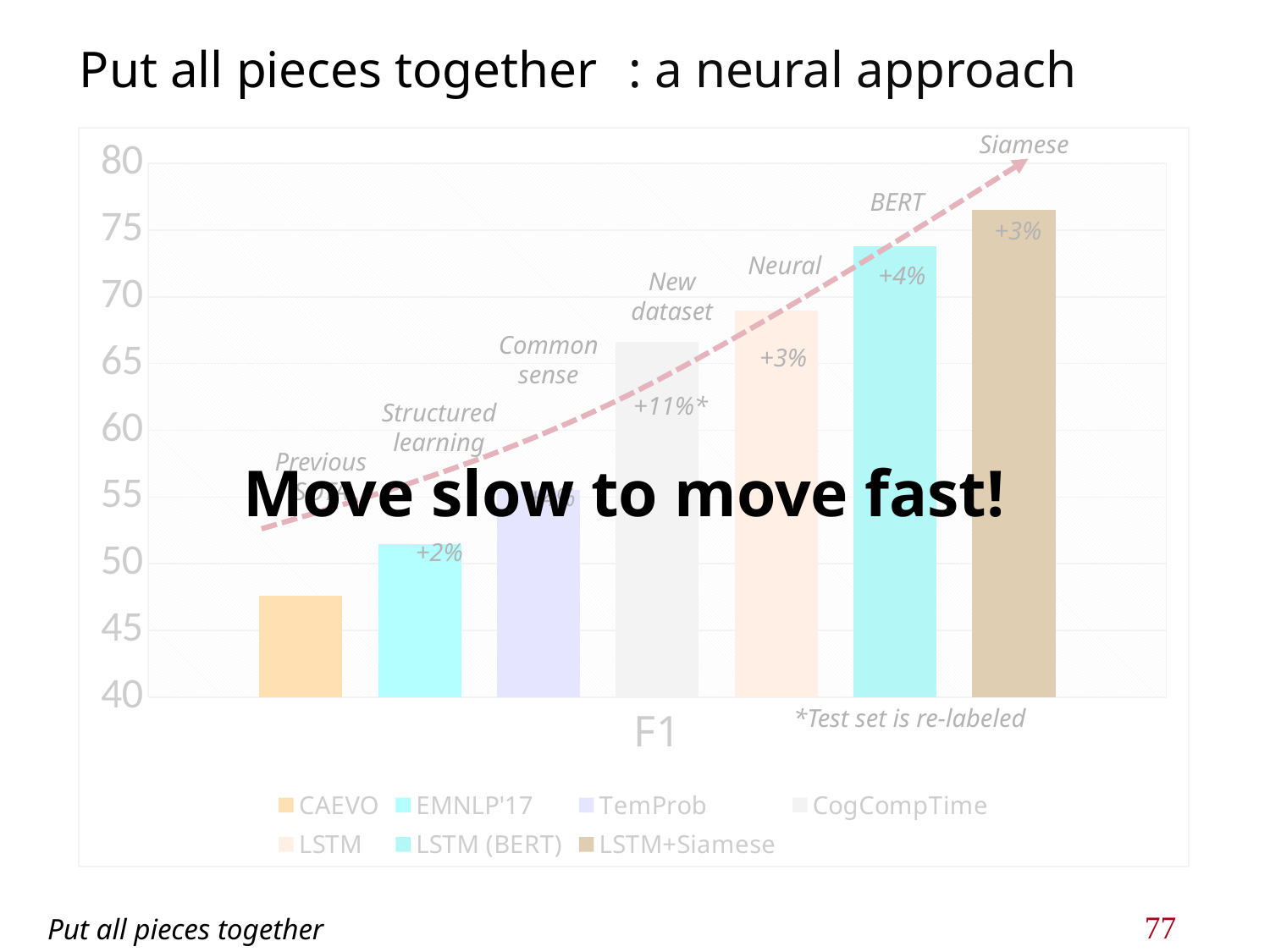
Is the F1 value for LSTM (BERT) greater or less than 70? greater Which series has the highest F1 bar? LSTM+Siamese Do the F1 bars rise or fall from left to right across the series? rise Is the F1 value for CAEVO greater or less than 50? less Which series has the lowest F1 bar? CAEVO Which is larger, the F1 bar for CogCompTime or the F1 bar for TemProb? CogCompTime How many categories are shown on the x axis? 1 Which is larger, the F1 bar for LSTM (BERT) or the F1 bar for LSTM? LSTM (BERT) Is the F1 value for LSTM+Siamese greater or less than 75? greater How many series does the legend list? 7 What improvement label is printed above the CogCompTime bar? +11%* What kind of chart is shown on the slide? bar chart